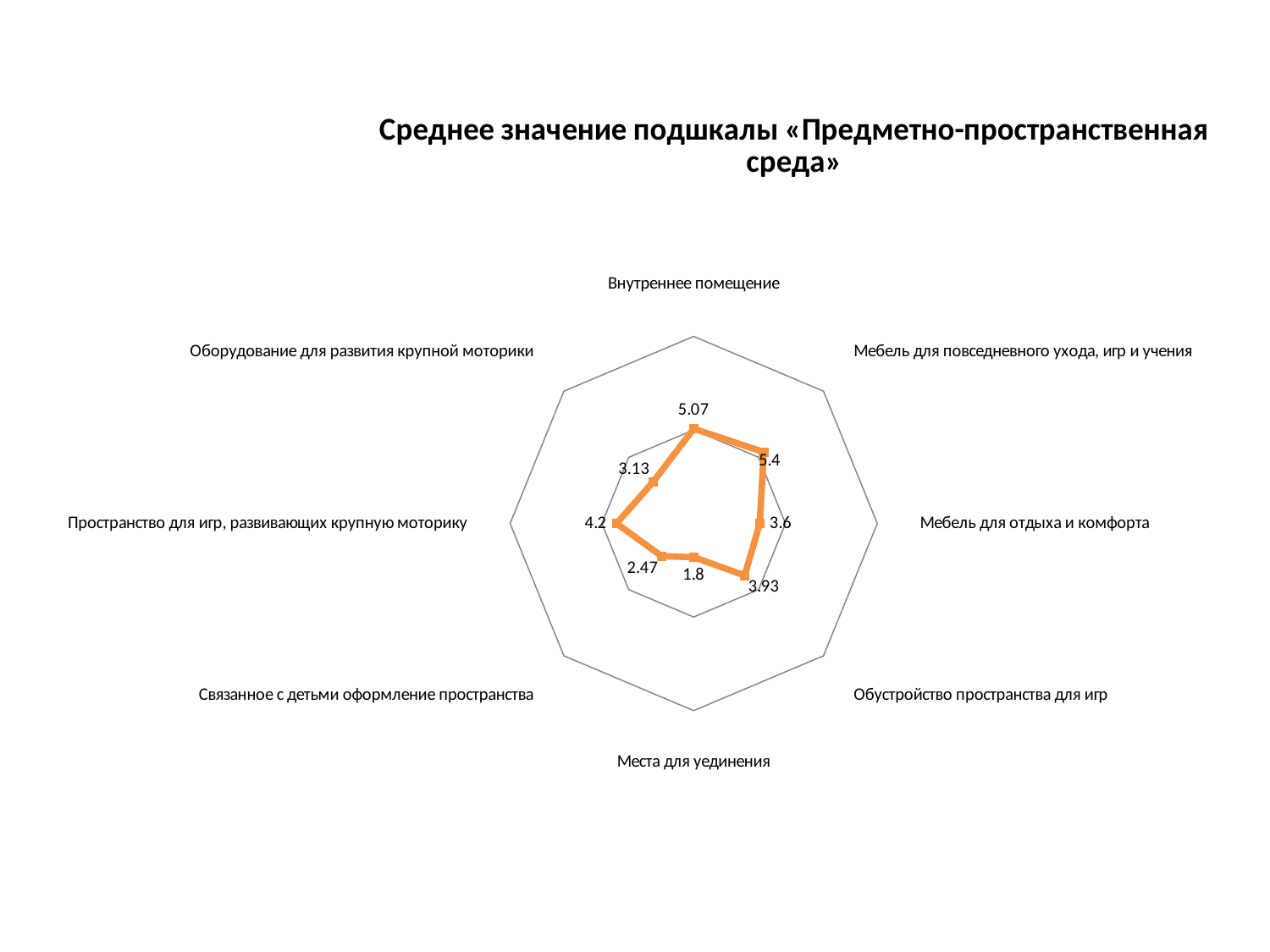
What is the difference between the values for «Внутреннее помещение» and «Места для уединения»? 3.27 Which category has the lowest value? Места для уединения What is the value for «Обустройство пространства для игр»? 3.93 How many categories are plotted on the radar chart? 8 What is the value for «Места для уединения»? 1.8 What is the value for «Мебель для повседневного ухода, игр и учения»? 5.4 What type of chart is shown on the slide? Radar chart What is the title of the chart? Среднее значение подшкалы «Предметно-пространственная среда» Which is larger: the value for «Мебель для отдыха и комфорта» or the value for «Оборудование для развития крупной моторики»? Мебель для отдыха и комфорта What is the value for «Внутреннее помещение»? 5.07 Which category has the highest value? Мебель для повседневного ухода, игр и учения What is the value for «Пространство для игр, развивающих крупную моторику»? 4.2